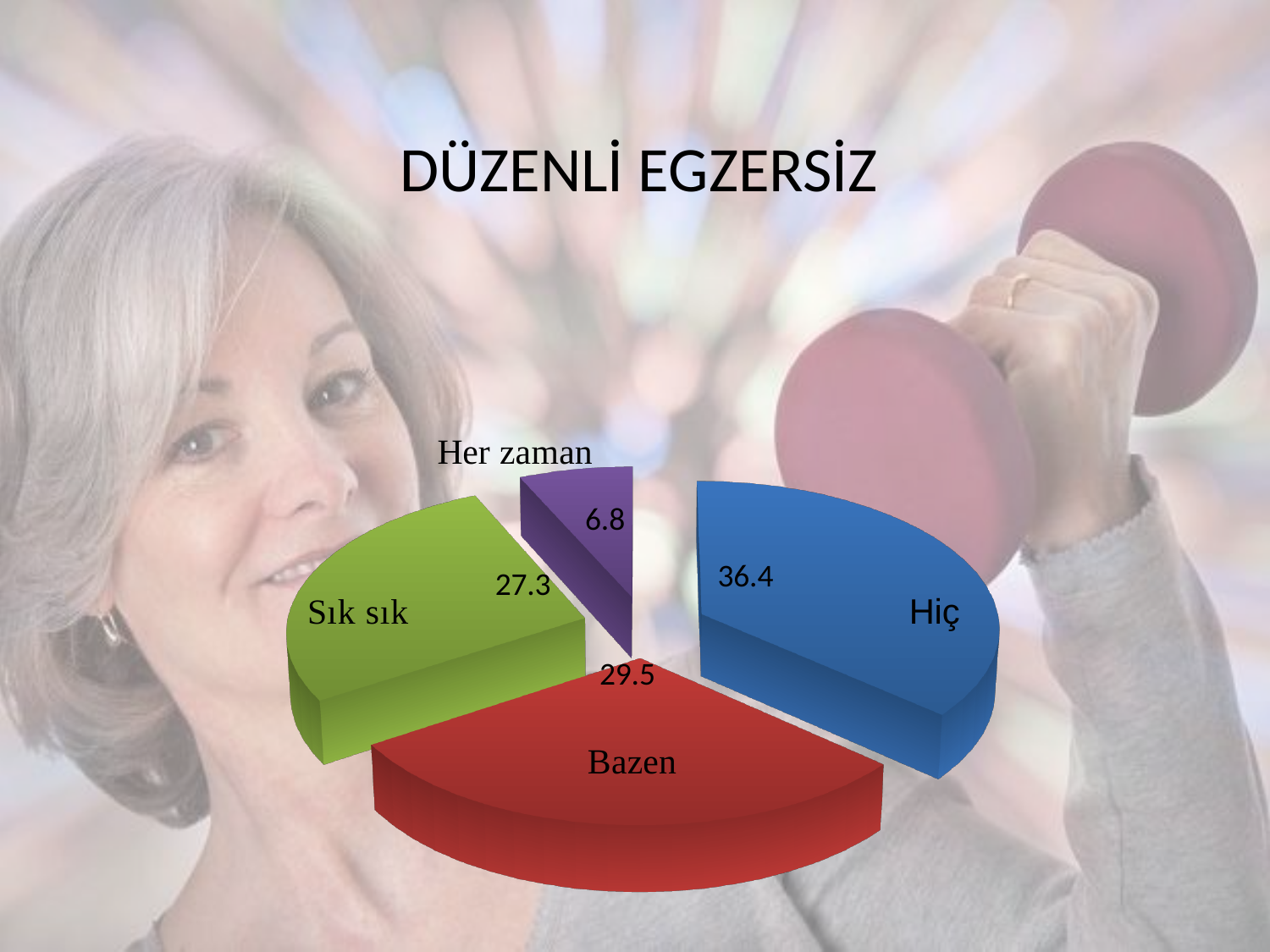
Which is larger, the value for Hiç or the value for Bazen? Hiç Which category has the largest slice? Hiç What is the title of the slide containing the chart? DÜZENLİ EGZERSİZ What kind of chart is shown on the slide? pie chart What is the difference between the values for Hiç and Her zaman? 29.6 Which category has the smallest slice? Her zaman What is the value for Hiç? 36.4 What is the value for Sık sık? 27.3 How many slices does the pie chart have? 4 What is the value for Bazen? 29.5 What is the difference between the values for Bazen and Sık sık? 2.2 What is the value for Her zaman? 6.8